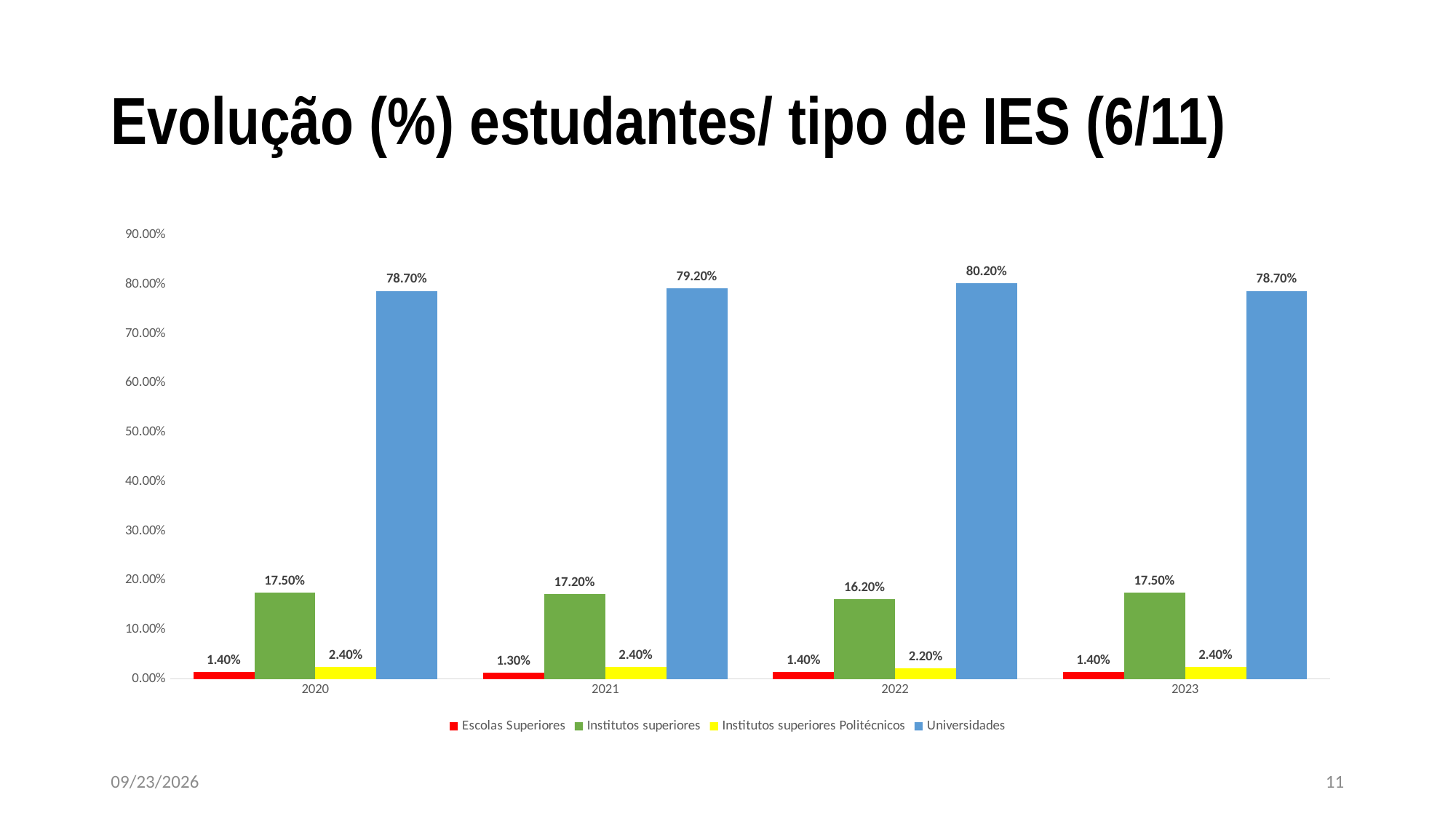
What is the value for Institutos superiores in 2021? 17.20% In which year is the Institutos superiores value lowest? 2022 What is the value for Escolas Superiores in 2021? 1.30% What is the difference between the Universidades values in 2022 and 2020? 1.50% What is the value for Institutos superiores Politécnicos in 2022? 2.20% What kind of chart is shown on the slide? Bar chart In which year is the Universidades value highest? 2022 How many years are shown on the x axis? 4 How many series does the legend list? 4 Which is larger: Institutos superiores in 2020 or Institutos superiores in 2022? Institutos superiores in 2020 What is the value for Universidades in 2022? 80.20% Which colour represents Universidades in the legend? Blue